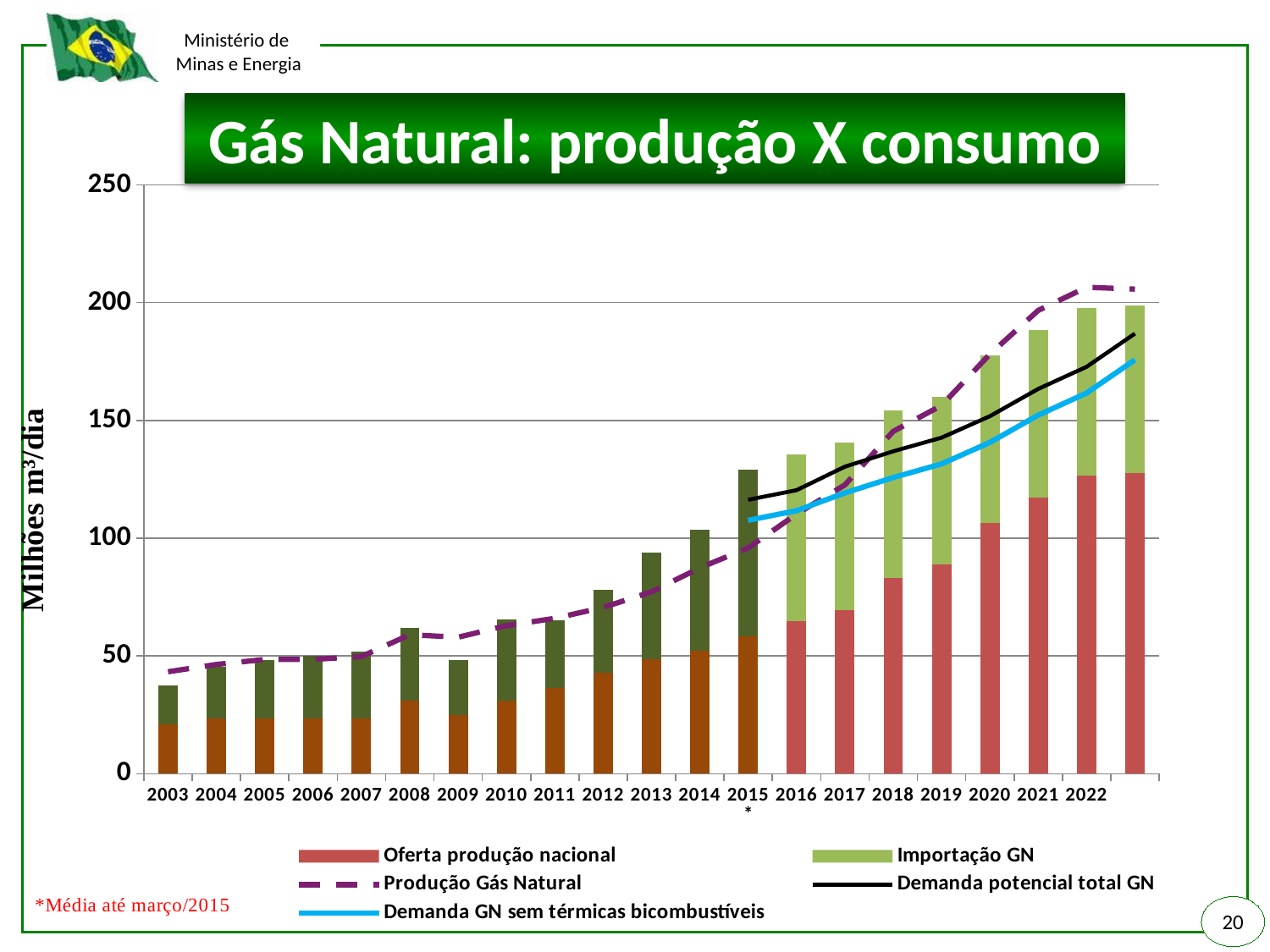
Is the total bar height for 2013 greater or less than 100? less What kind of chart is shown on the slide? A stacked bar chart combined with line series What is the title of the chart? Gás Natural: produção X consumo Do the total bar heights generally rise or fall from 2003 to 2022? rise Which year has the taller total bar, 2008 or 2009? 2008 Which labeled year has the lowest total bar? 2003 What is the label on the vertical axis? Milhões m³/dia Is the total bar height for 2015 greater or less than 100? greater Is the total bar height for 2003 greater or less than 50? less How many series does the legend list? 5